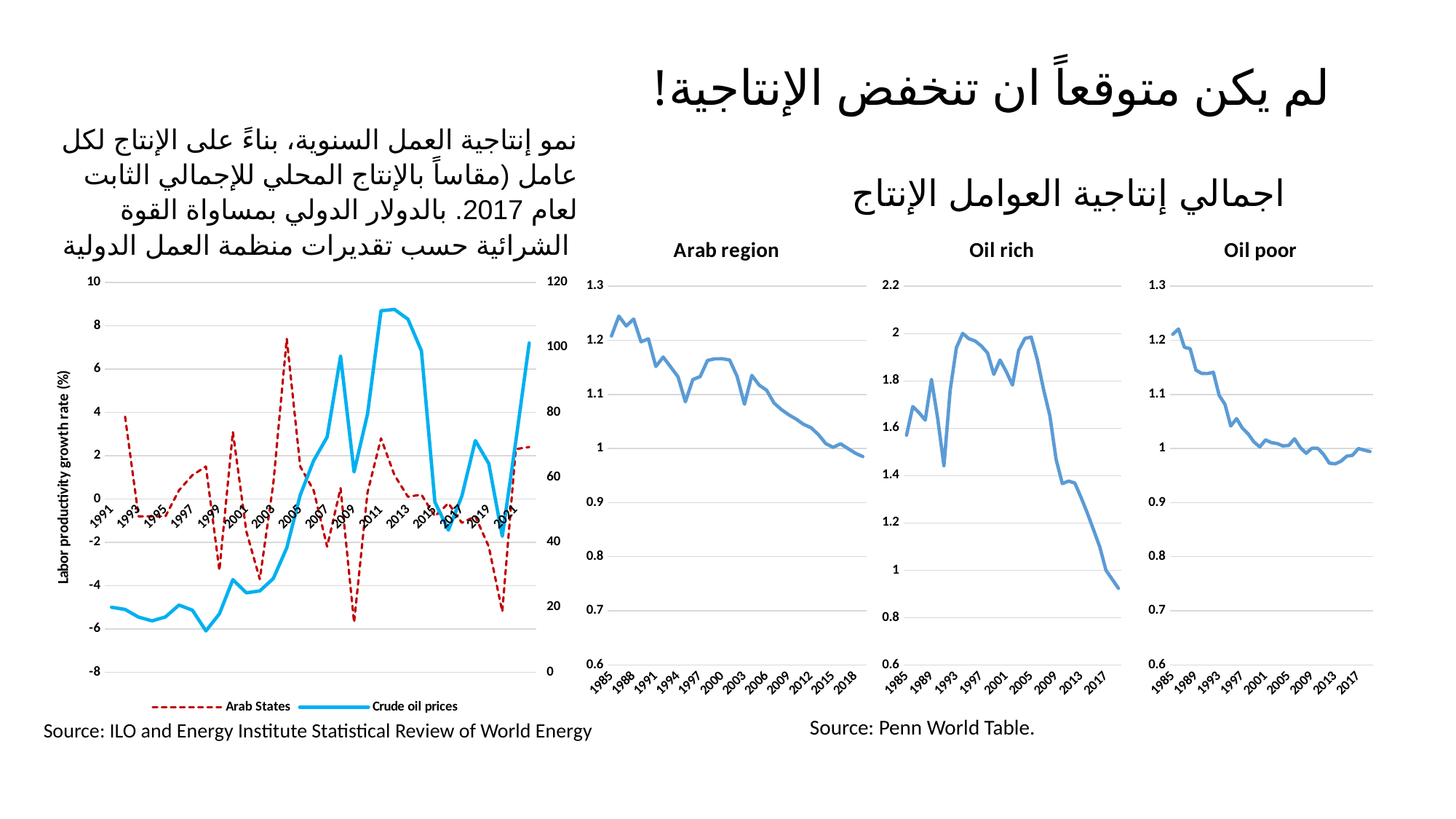
How many series does the legend of the left chart (Labor productivity growth rate) list? 2 What are the two series named in the legend of the left chart (Labor productivity growth rate)? Arab States and Crude oil prices In the 'Oil poor' chart, is the value in 1985 greater or less than 1.1? greater In the 'Arab region' chart, do the values generally rise or fall from 1985 to 2018? fall In the 'Oil rich' chart, is the final value at the end of the series greater or less than 1? less In the left chart, which series is drawn as a dashed red line? Arab States In the left chart, is the peak of the Crude oil prices line around 2011-2012 greater or less than 100 on the right axis? greater What kind of chart is the chart on the left of the slide with the 'Labor productivity growth rate (%)' axis? line chart In the 'Oil poor' chart, do the values generally rise or fall from 1985 to 2017? fall